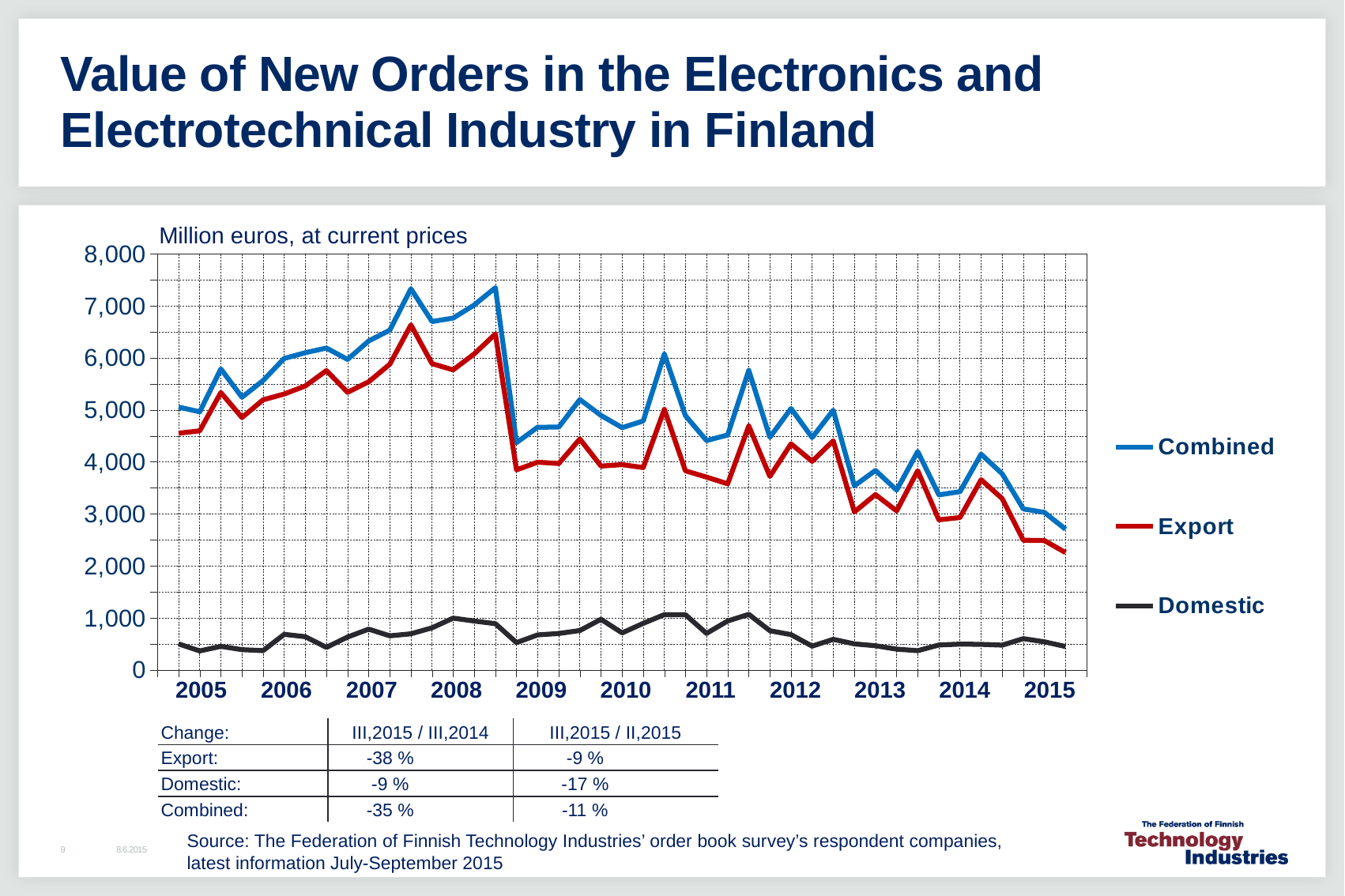
Which series is larger in 2012, Export or Domestic? Export What kind of chart is shown on the slide? Line chart Is the peak value of the Combined series in 2008 greater or less than 7,000? greater Does the Combined series rise or fall from 2014 to 2015? Fall What unit is stated above the chart's y axis? Million euros, at current prices How many years are labelled on the chart's x axis? 11 Is the last value of the Export series in 2015 greater or less than 3,000? less How many series does the chart's legend list? 3 Is the value of the Domestic series ever greater or less than 2,000 across the chart? less Which series has the lowest values throughout the chart? Domestic Which series has the highest values throughout the chart? Combined Which series are listed in the chart's legend? Combined, Export, Domestic